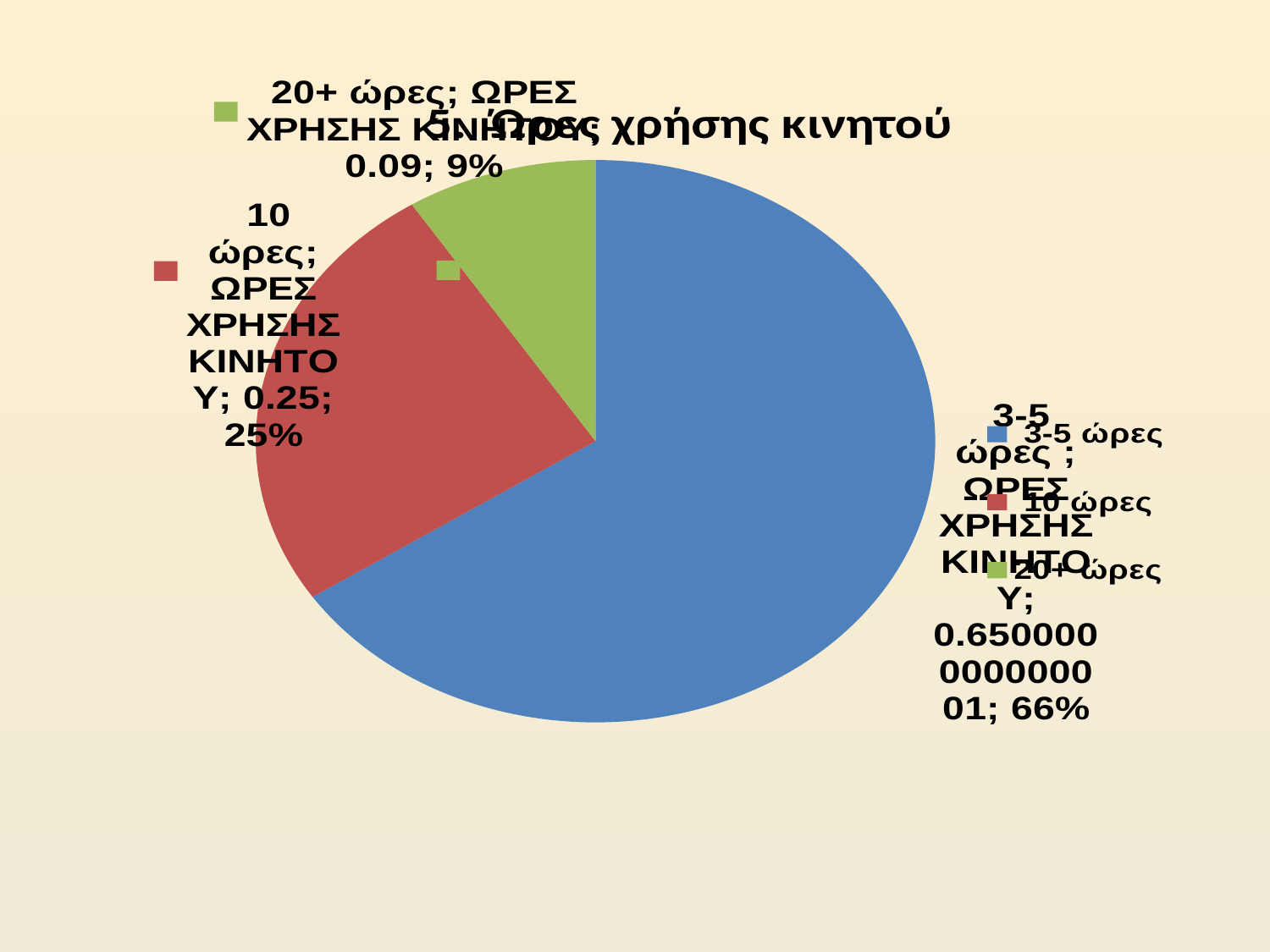
What is the difference in percentage points between the '3-5 ώρες' slice and the '10 ώρες' slice? 41% What percentage share does the '3-5 ώρες' slice have? 66% What is the title of the chart? 5. Ώρες χρήσης κινητού Which category has the smallest slice of the pie? 20+ ώρες Which category has the largest slice of the pie? 3-5 ώρες What colour is the '3-5 ώρες' slice? blue What percentage share does the '10 ώρες' slice have? 25% How many entries does the legend list? 3 What percentage share does the '20+ ώρες' slice have? 9% What kind of chart is shown on the slide? pie chart Which slice is larger, '10 ώρες' or '20+ ώρες'? 10 ώρες How many slices does the pie chart have? 3